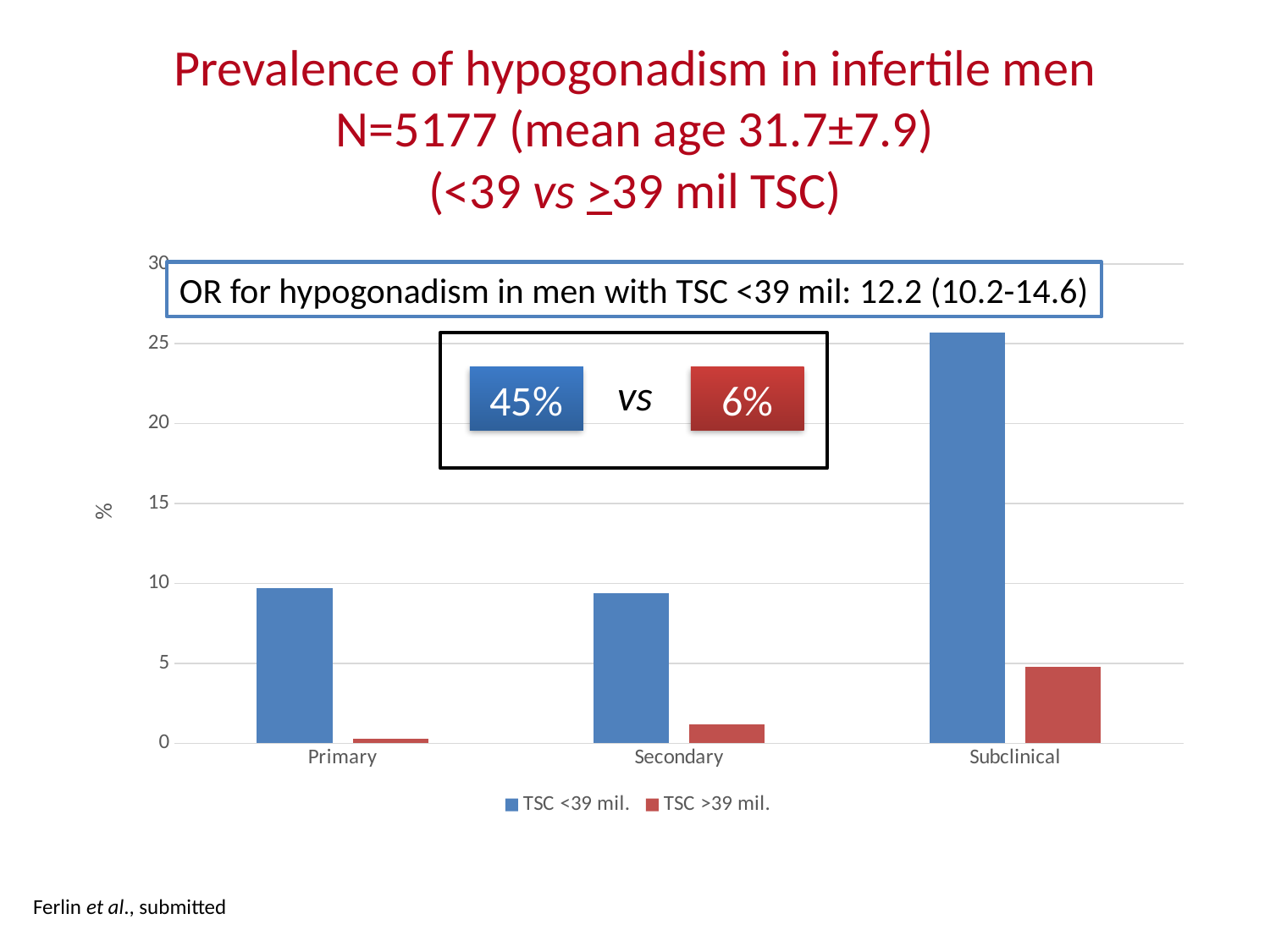
In the Secondary category, which series has the larger value, TSC <39 mil. or TSC >39 mil.? TSC <39 mil. Which is larger: the TSC <39 mil. value for Subclinical or the TSC <39 mil. value for Secondary? Subclinical How many categories are shown on the x axis of the chart? 3 What kind of chart is shown on the slide? bar chart Which category has the highest value for TSC >39 mil.? Subclinical What colour are the bars for the TSC <39 mil. series? blue How many series does the chart legend list? 2 Which category has the highest value for TSC <39 mil.? Subclinical Which category has the lowest value for TSC >39 mil.? Primary Is the value for TSC <39 mil. in the Subclinical category greater or less than 25? greater